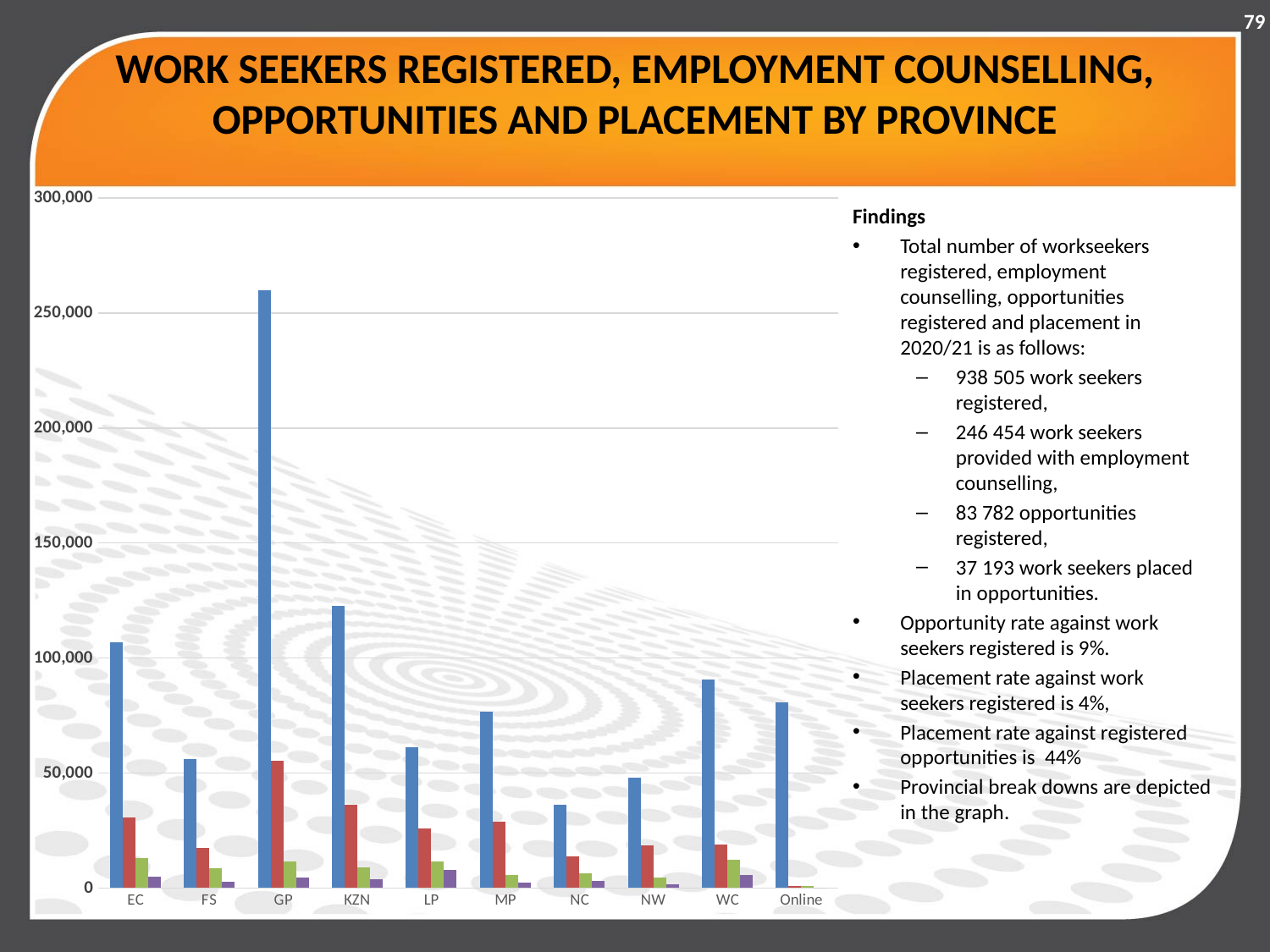
Is the blue (first) bar for NC greater or less than 50,000? less Is the blue (first) bar for EC greater or less than 100,000? greater Is the blue (first) bar for KZN greater or less than 150,000? less Which category has the shortest blue (first) bar in the chart? NC Which has the taller blue (first) bar, FS or WC? WC Which has the taller blue (first) bar, KZN or MP? KZN What is the highest value shown on the vertical axis of the chart? 300,000 Which category has the tallest blue (first) bar in the chart? GP What kind of chart is shown on the slide? bar chart How many categories are shown along the x axis of the chart? 10